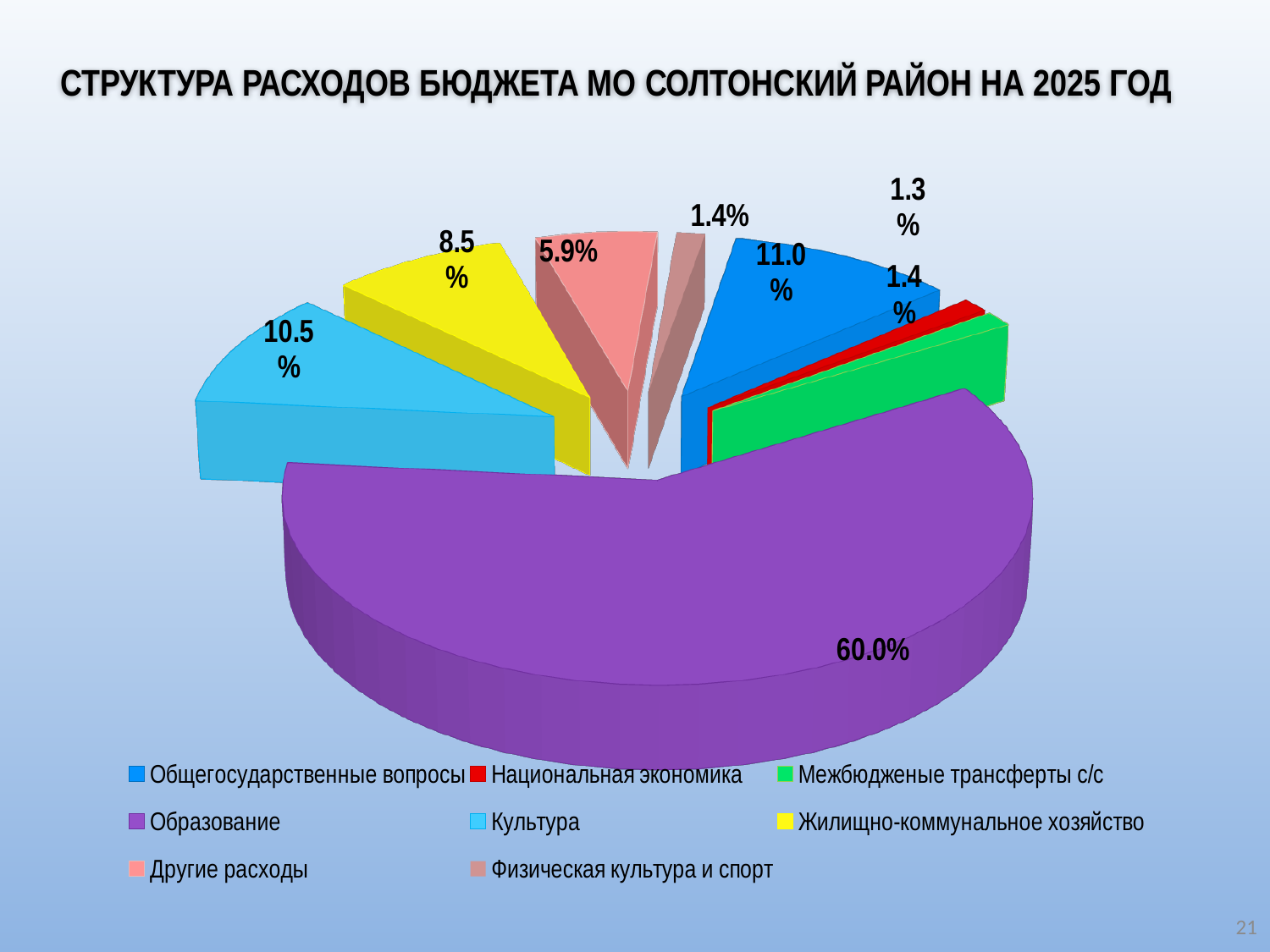
Which is larger, the share for Культура or for Жилищно-коммунальное хозяйство? Культура What percentage is shown for Жилищно-коммунальное хозяйство? 8.5% What is the title of the chart? СТРУКТУРА РАСХОДОВ БЮДЖЕТА МО СОЛТОНСКИЙ РАЙОН НА 2025 ГОД What share is shown for Общегосударственные вопросы? 11.0% What is the value shown for Культура? 10.5% Which category has the largest share of the pie? Образование What is the value for Другие расходы? 5.9% What type of chart is shown on the slide? Pie chart How many slices does the pie chart have? 8 What colour represents Образование in the chart? Purple What share of the budget expenditure does Образование account for? 60.0% By how many percentage points does Образование exceed Общегосударственные вопросы? 49.0 percentage points